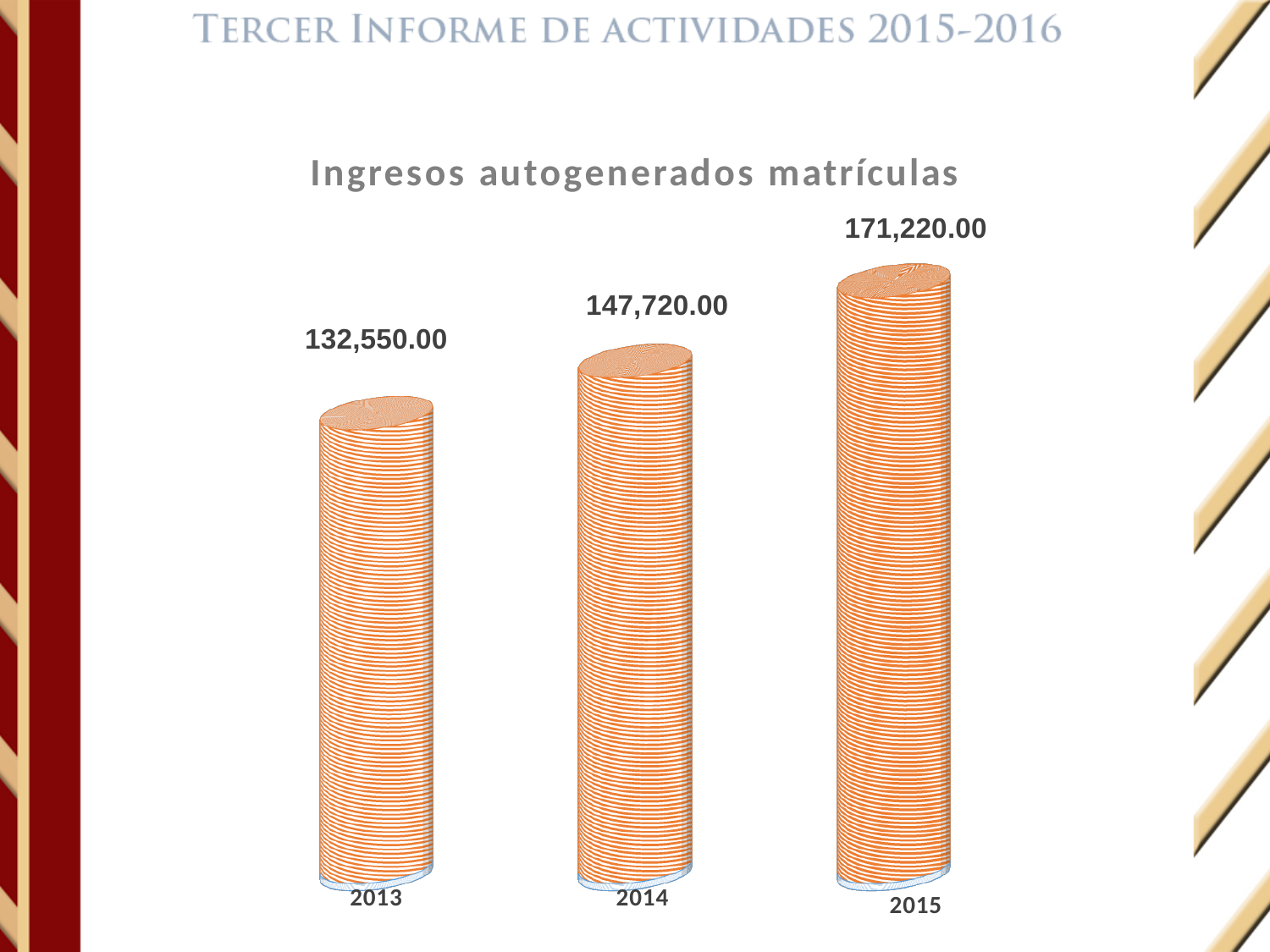
What is the value for 2013? 132,550.00 What is the value for 2015? 171,220.00 What is the title of the chart? Ingresos autogenerados matrículas Which year has the highest value? 2015 Which is larger, the value for 2013 or the value for 2015? 2015 How many years are shown in the chart? 3 Do the values rise or fall from 2013 to 2015? rise What is the difference between the values for 2015 and 2014? 23,500.00 What is the value for 2014? 147,720.00 Which year has the lowest value? 2013 What is the difference between the values for 2014 and 2013? 15,170.00 What kind of chart is this? bar chart